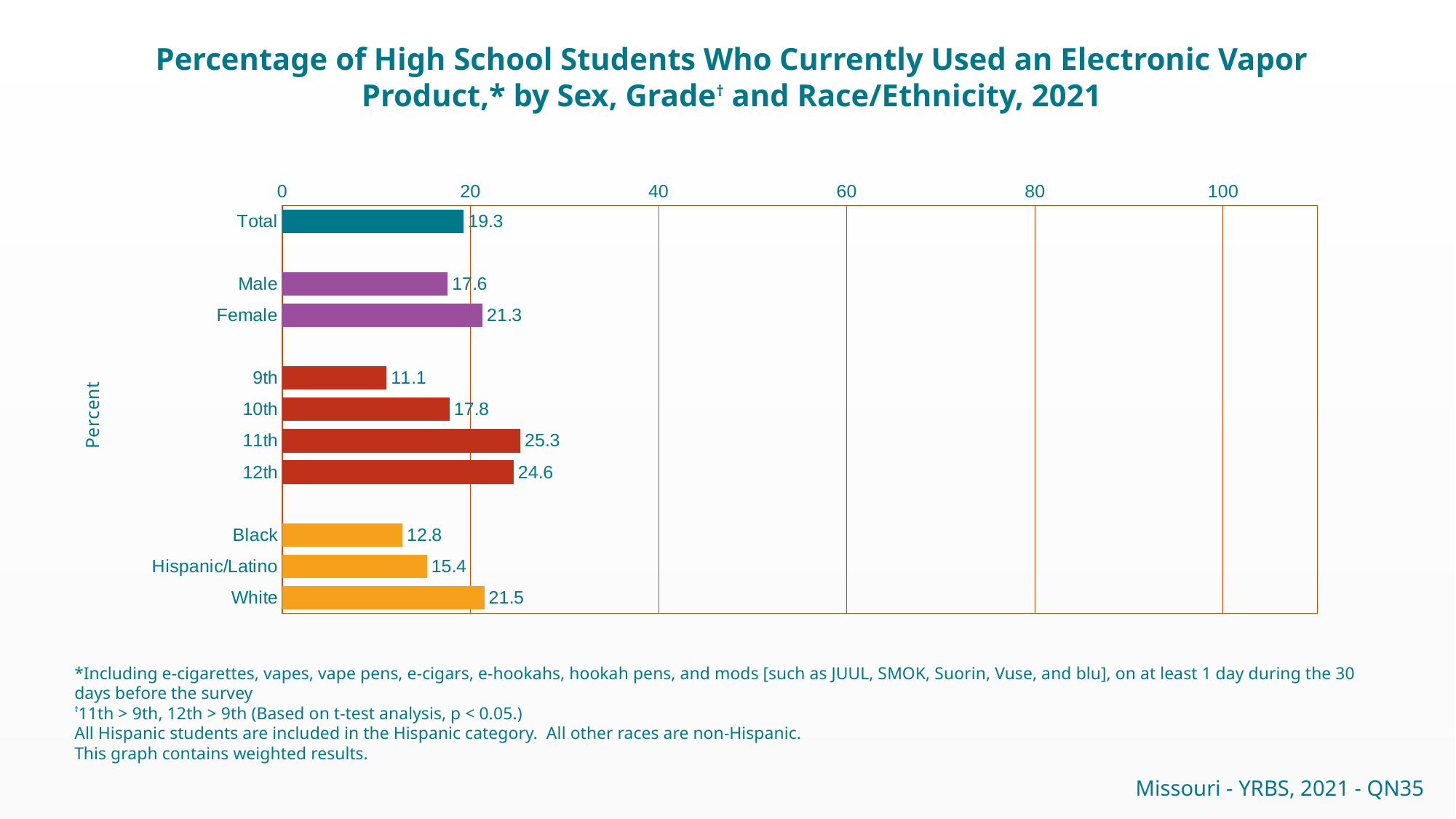
How many categories are shown in the chart? 11 What is the difference between the values for White and Black? 8.7 What is the value for Female? 21.3 What is the value for Hispanic/Latino? 15.4 Which category has the lowest value? 9th What kind of chart is shown on the slide? bar chart Is the value for 10th greater or less than 20? less What is the value for 9th grade? 11.1 What is the difference between the values for Female and Male? 3.7 What is the value for Total? 19.3 Which is larger, the value for 11th or the value for 12th? 11th Which category has the highest value? 11th